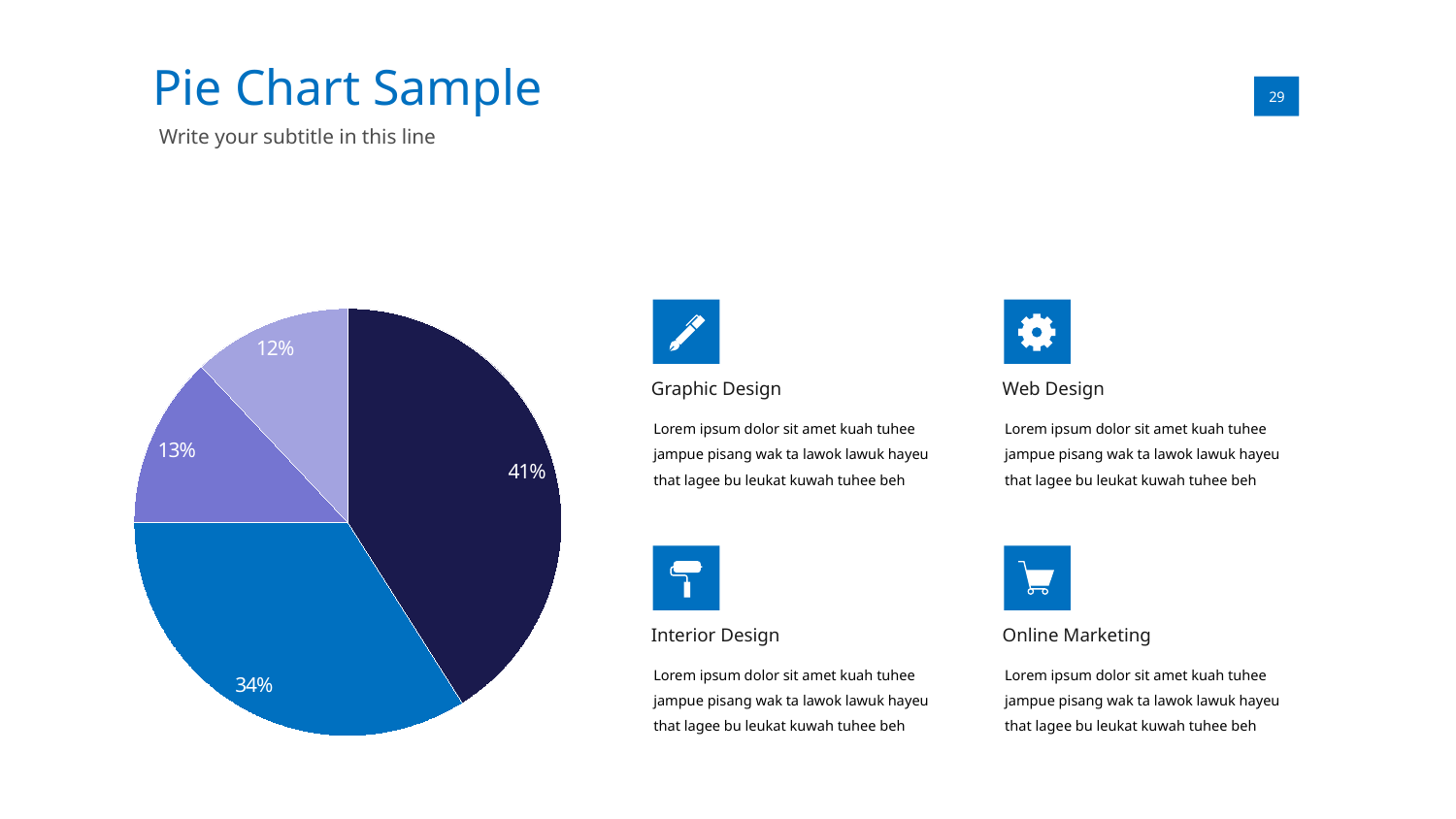
What is the value of the smallest slice in the pie chart? 12% What is the difference between the 13% slice and the 12% slice? 1 percentage point What is the value of the light lavender slice at the top of the pie? 12% What colour is the 41% slice of the pie chart? Dark navy What is the difference between the 41% slice and the 34% slice? 7 percentage points How many slices does the pie chart have? 4 What kind of chart is shown on the slide? Pie chart What do the four slice percentages add up to? 100% What is the title of the slide containing the pie chart? Pie Chart Sample Which is larger, the dark navy slice or the bright blue slice? The dark navy slice (41%) What is the value of the largest slice in the pie chart? 41% What is the value of the bright blue slice at the bottom of the pie? 34%